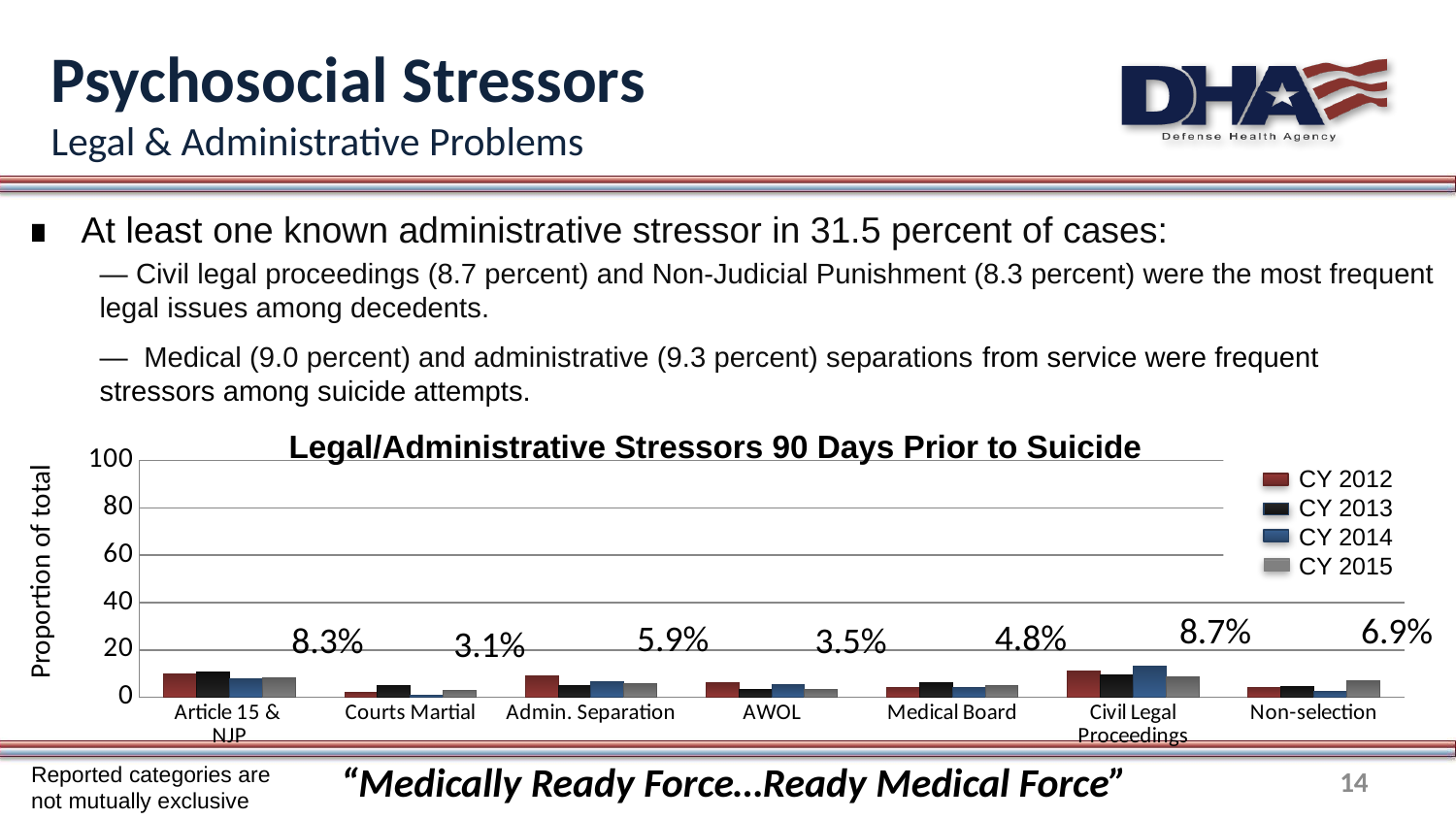
What is the difference between the printed labels for Civil Legal Proceedings (8.7%) and Courts Martial (3.1%)? 5.6% Which category has the lowest printed data label? Courts Martial Which category has the highest printed data label? Civil Legal Proceedings Which printed label is larger, Civil Legal Proceedings or Non-selection? Civil Legal Proceedings What data label is printed above the Civil Legal Proceedings group? 8.7% How many series does the chart legend list? 4 What data label is printed above the Admin. Separation group? 5.9% What kind of chart is shown on the slide? bar chart Is the CY 2012 value for Article 15 & NJP greater or less than 20? less What data label is printed above the Courts Martial group? 3.1% What is the title of the chart? Legal/Administrative Stressors 90 Days Prior to Suicide How many categories are shown along the x axis of the chart? 7